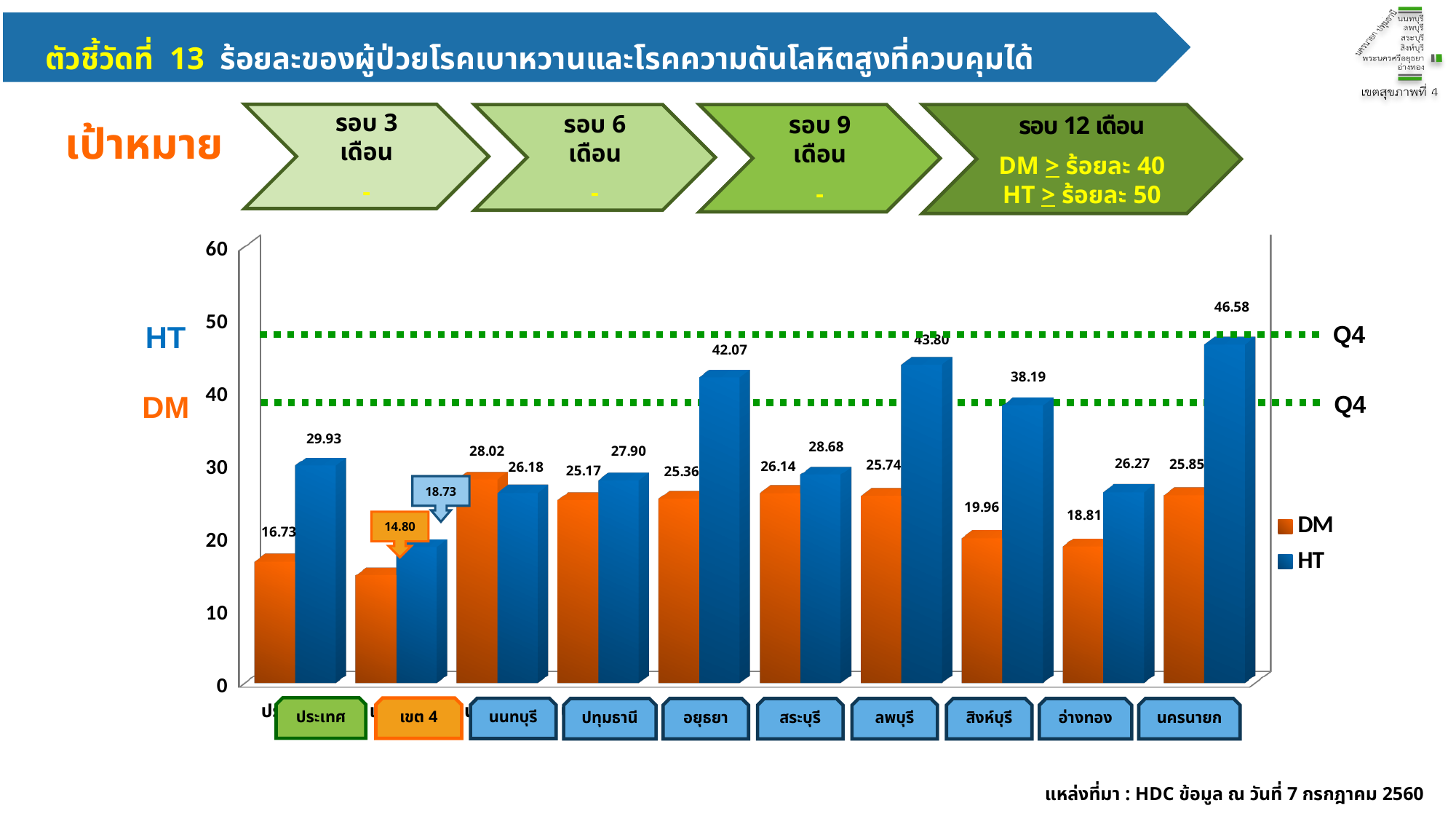
Which category has the highest DM value? นนทบุรี What is the difference between the HT and DM values for นครนายก? 20.73 Which category has the highest HT value? นครนายก How many series does the chart legend list? 2 What is the HT value for อยุธยา? 42.07 What is the DM value for ประเทศ? 16.73 What is the HT value for นครนายก? 46.58 How many categories are shown on the x axis of the chart? 10 What is the DM value for เขต 4? 14.80 For นนทบุรี, which is larger, the DM value or the HT value? DM Which category has the lowest DM value? เขต 4 What kind of chart is shown on the slide? bar chart